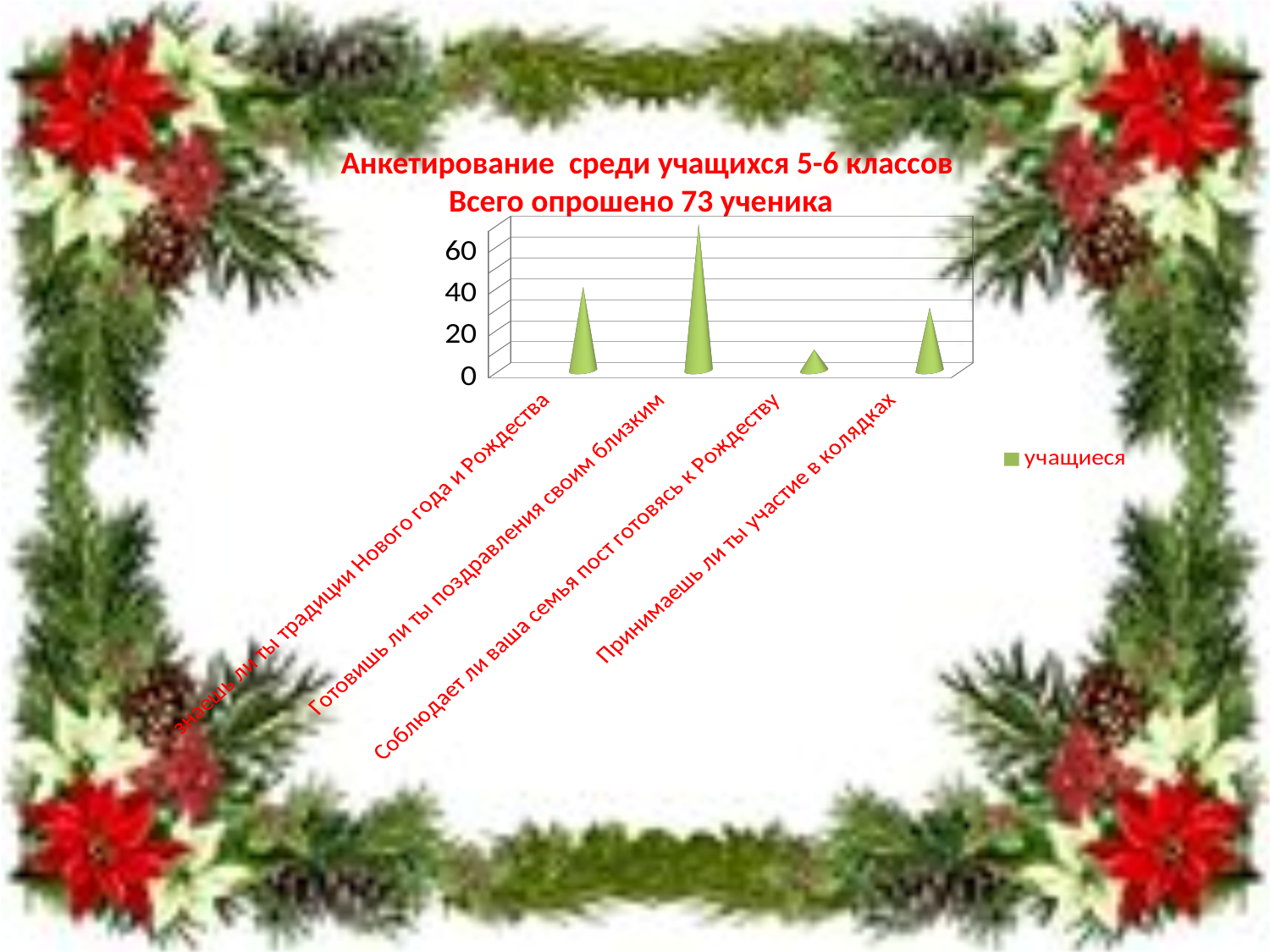
Which category has the highest value? Готовишь ли ты поздравления своим близким According to the chart title, how many pupils were surveyed in total? 73 How many series does the legend list? 1 What is the name of the series shown in the legend? учащиеся Is the value for 'Готовишь ли ты поздравления своим близким' greater or less than 60? greater How many categories are plotted on the chart? 4 Which is larger: the value for 'Знаешь ли ты традиции Нового года и Рождества' or the value for 'Принимаешь ли ты участие в колядках'? Знаешь ли ты традиции Нового года и Рождества Which is larger: the value for 'Готовишь ли ты поздравления своим близким' or the value for 'Соблюдает ли ваша семья пост готовясь к Рождеству'? Готовишь ли ты поздравления своим близким What kind of chart is shown on the slide? bar chart Is the value for 'Принимаешь ли ты участие в колядках' greater or less than 40? less Is the value for 'Соблюдает ли ваша семья пост готовясь к Рождеству' greater or less than 20? less Which category has the lowest value? Соблюдает ли ваша семья пост готовясь к Рождеству